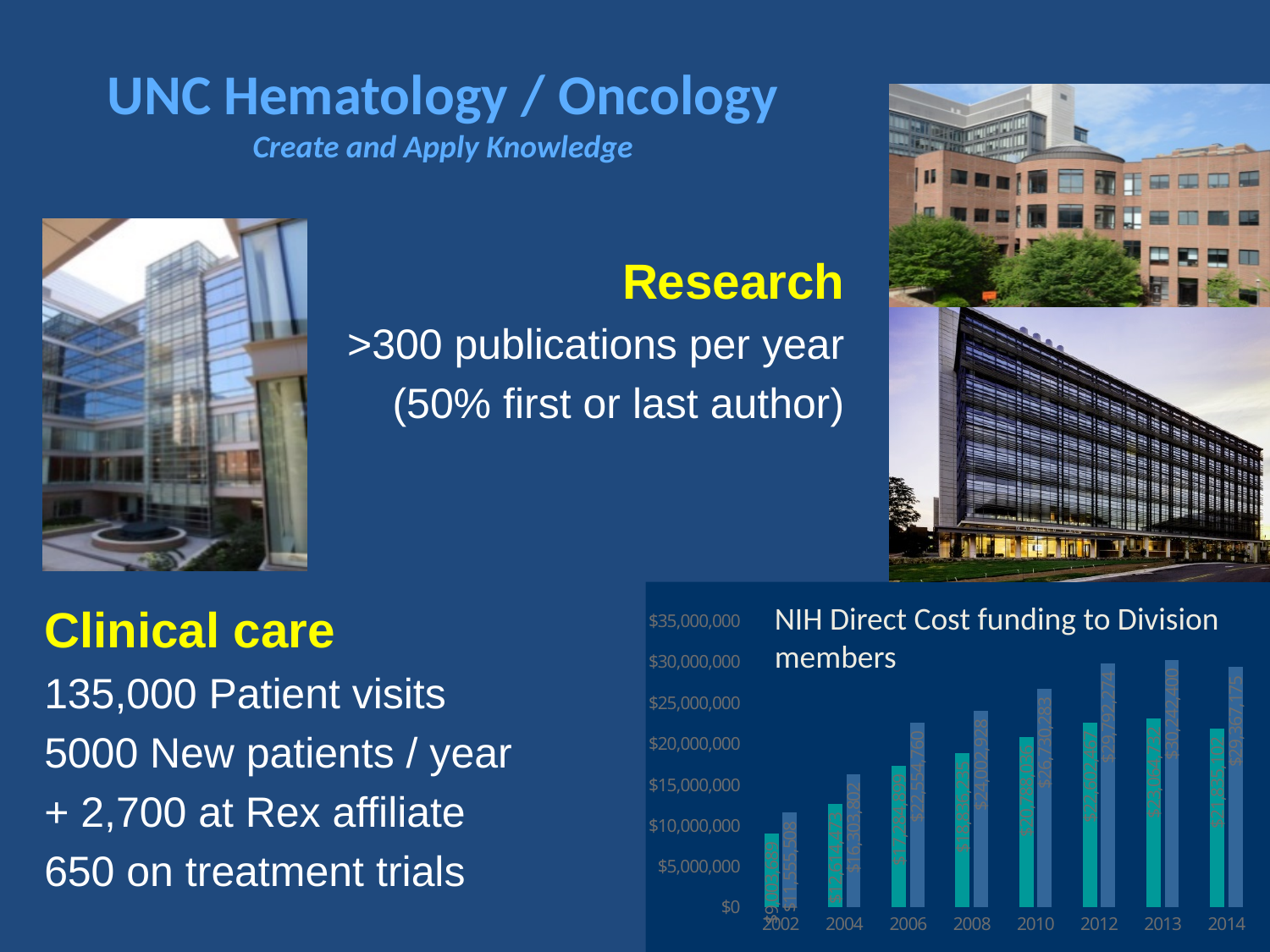
In the NIH Direct Cost funding chart, what is the value of the right-hand (lighter blue) bar for 2002? $11,555,508 How many years are shown on the x axis of the NIH Direct Cost funding chart? 8 In the NIH Direct Cost funding chart, what is the value of the right-hand (lighter blue) bar for 2014? $29,367,175 In the NIH Direct Cost funding chart, what is the difference between the right-hand (lighter blue) bars for 2013 and 2014? $875,225 In the NIH Direct Cost funding chart, is the left-hand (teal) bar for 2002 greater or less than $10,000,000? less In the NIH Direct Cost funding chart, what is the value of the right-hand (lighter blue) bar for 2013? $30,242,400 In the NIH Direct Cost funding chart, which year has the lowest right-hand (lighter blue) bar? 2002 What is the title of the chart at the bottom right of the slide? NIH Direct Cost funding to Division members In the NIH Direct Cost funding chart, which year has the highest right-hand (lighter blue) bar? 2013 In the NIH Direct Cost funding chart, what is the value of the right-hand (lighter blue) bar for 2008? $24,002,928 What kind of chart is the 'NIH Direct Cost funding to Division members' chart? bar chart Overall, do the bars in the NIH Direct Cost funding chart rise or fall from 2002 to 2014? rise